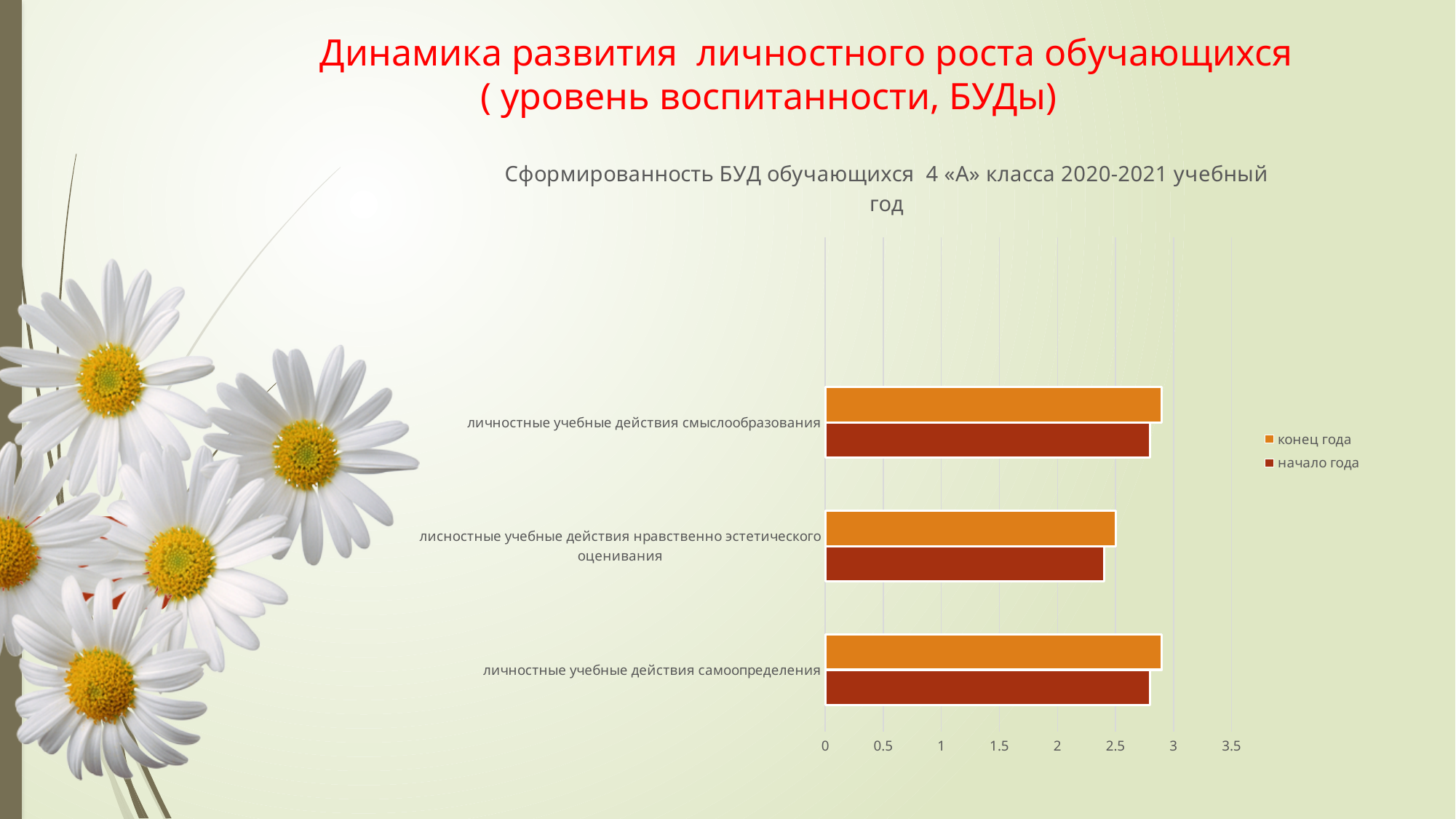
For 'личностные учебные действия смыслообразования', which is larger: 'конец года' or 'начало года'? конец года Which category has the lowest value for the series 'начало года'? лисностные учебные действия нравственно эстетического оценивания How many categories are plotted on the chart? 3 Is the 'конец года' value for 'личностные учебные действия самоопределения' greater or less than 3? less What kind of chart is shown on the slide? bar chart What are the two series named in the legend? конец года, начало года Is the 'конец года' value for 'личностные учебные действия смыслообразования' greater or less than 2.5? greater For 'личностные учебные действия самоопределения', which is larger: 'конец года' or 'начало года'? конец года How many series does the chart legend list? 2 What is the title of the chart? Сформированность БУД обучающихся 4 «А» класса 2020-2021 учебный год Which category has the lowest value for the series 'конец года'? лисностные учебные действия нравственно эстетического оценивания Is the 'начало года' value for 'лисностные учебные действия нравственно эстетического оценивания' greater or less than 2.5? less